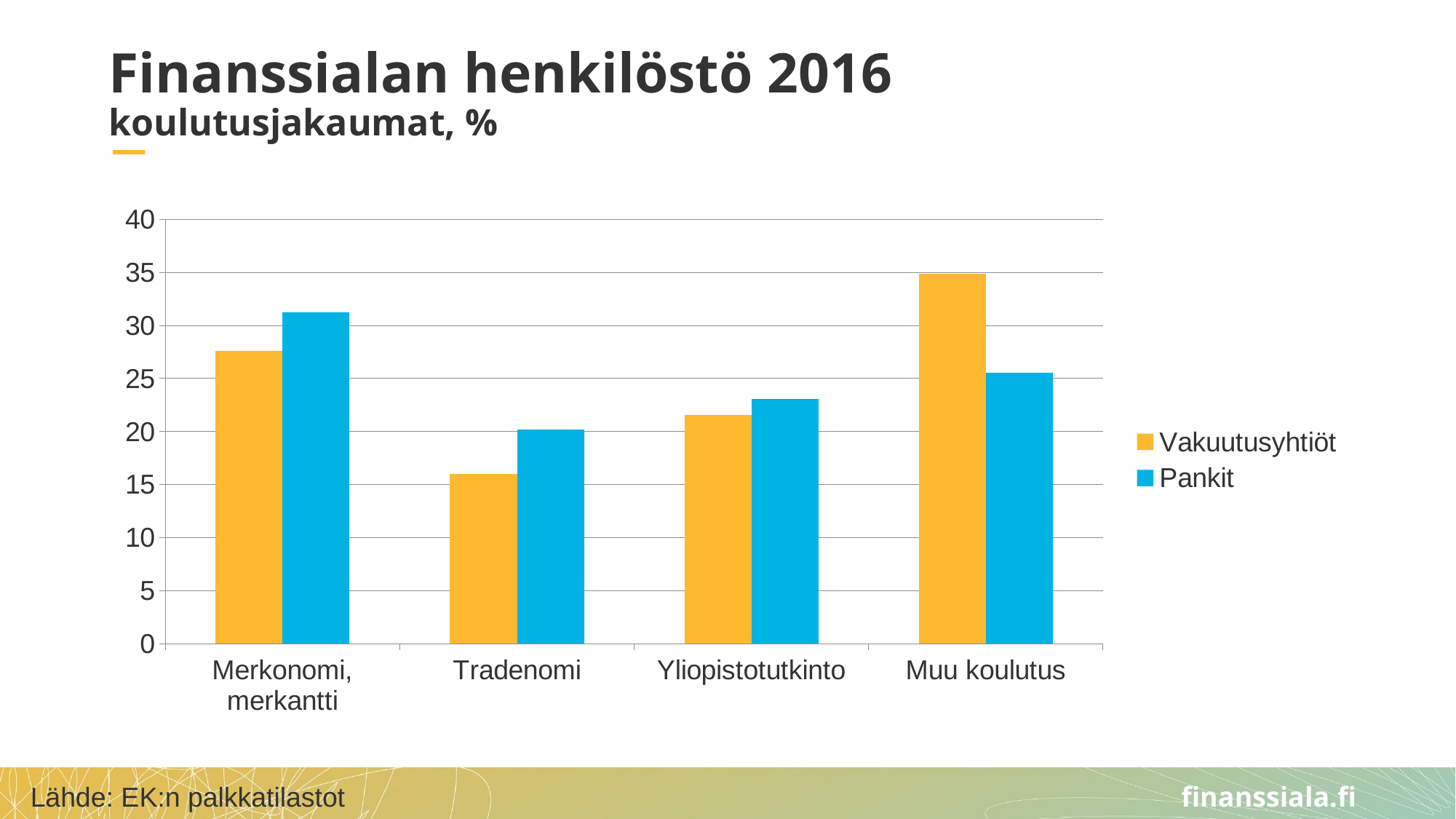
Which category has the highest value for Pankit? Merkonomi, merkantti How many series does the legend list? 2 Is the Pankit value for Merkonomi, merkantti greater or less than 30? greater Which category has the lowest value for Vakuutusyhtiöt? Tradenomi Which category has the lowest value for Pankit? Tradenomi How many education categories are shown on the x axis? 4 Is the Vakuutusyhtiöt value for Tradenomi greater or less than 20? less Which category has the highest value for Vakuutusyhtiöt? Muu koulutus For Tradenomi, which series has the larger value, Vakuutusyhtiöt or Pankit? Pankit For Muu koulutus, which series has the larger value, Vakuutusyhtiöt or Pankit? Vakuutusyhtiöt Which colour represents Pankit in the chart? blue What kind of chart is shown on the slide? bar chart